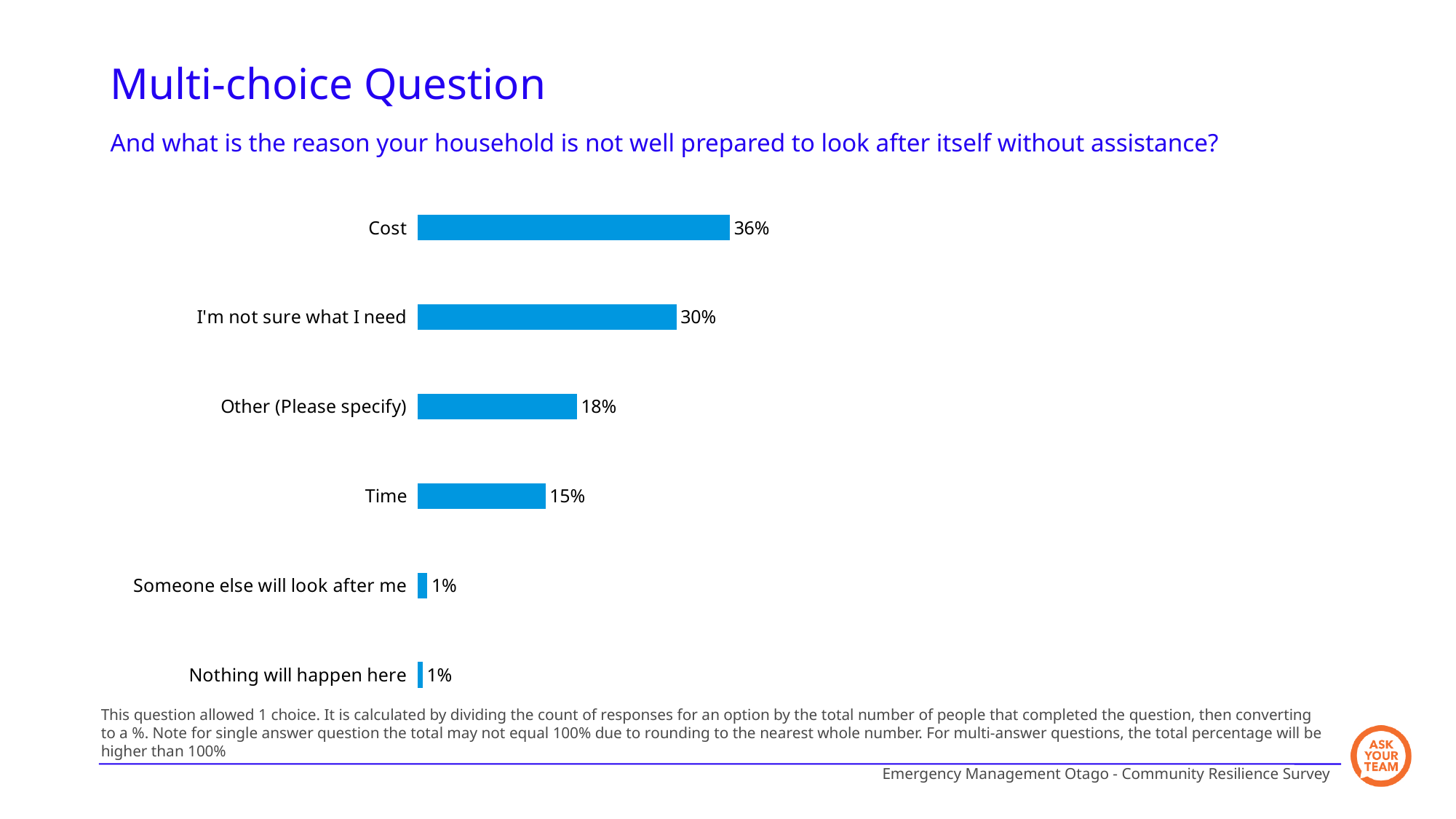
What percentage of respondents gave Cost as the reason their household is not well prepared? 36% What is the value for 'I'm not sure what I need'? 30% How many reasons (categories) are shown in the chart? 6 What is the difference in percentage points between Cost and 'I'm not sure what I need'? 6 What kind of chart is shown on the slide? Bar chart Which is larger, the value for Time or the value for 'Other (Please specify)'? Other (Please specify) What value is shown for 'Someone else will look after me'? 1% What colour are the bars in the chart? Blue What percentage is shown for Time? 15% Which reason has the highest percentage? Cost What is the difference in percentage points between 'Other (Please specify)' and Time? 3 What is the value for 'Other (Please specify)'? 18%